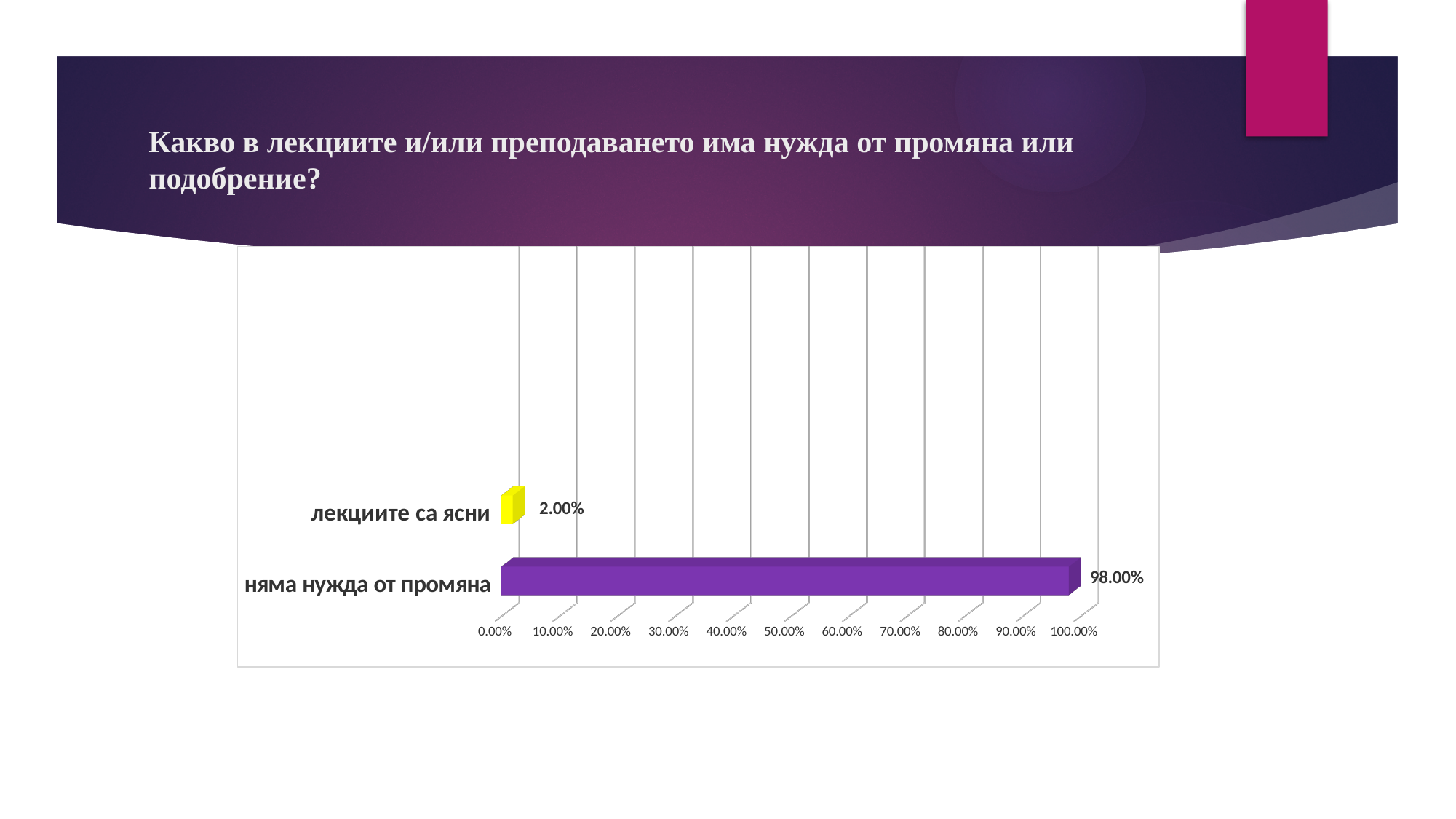
What is the difference between the values for "няма нужда от промяна" and "лекциите са ясни"? 96.00% Is the value for "лекциите са ясни" greater or less than 10.00%? less Is the value for "няма нужда от промяна" greater or less than 90.00%? greater Which is larger, the value for "лекциите са ясни" or the value for "няма нужда от промяна"? няма нужда от промяна What is the value for "лекциите са ясни"? 2.00% What is the total of the two values shown in the chart? 100.00% What kind of chart is shown on the slide? bar chart What colour is the bar for "лекциите са ясни"? yellow How many categories are shown in the chart? 2 Which category has the lowest value? лекциите са ясни Which category has the highest value? няма нужда от промяна What is the value for "няма нужда от промяна"? 98.00%